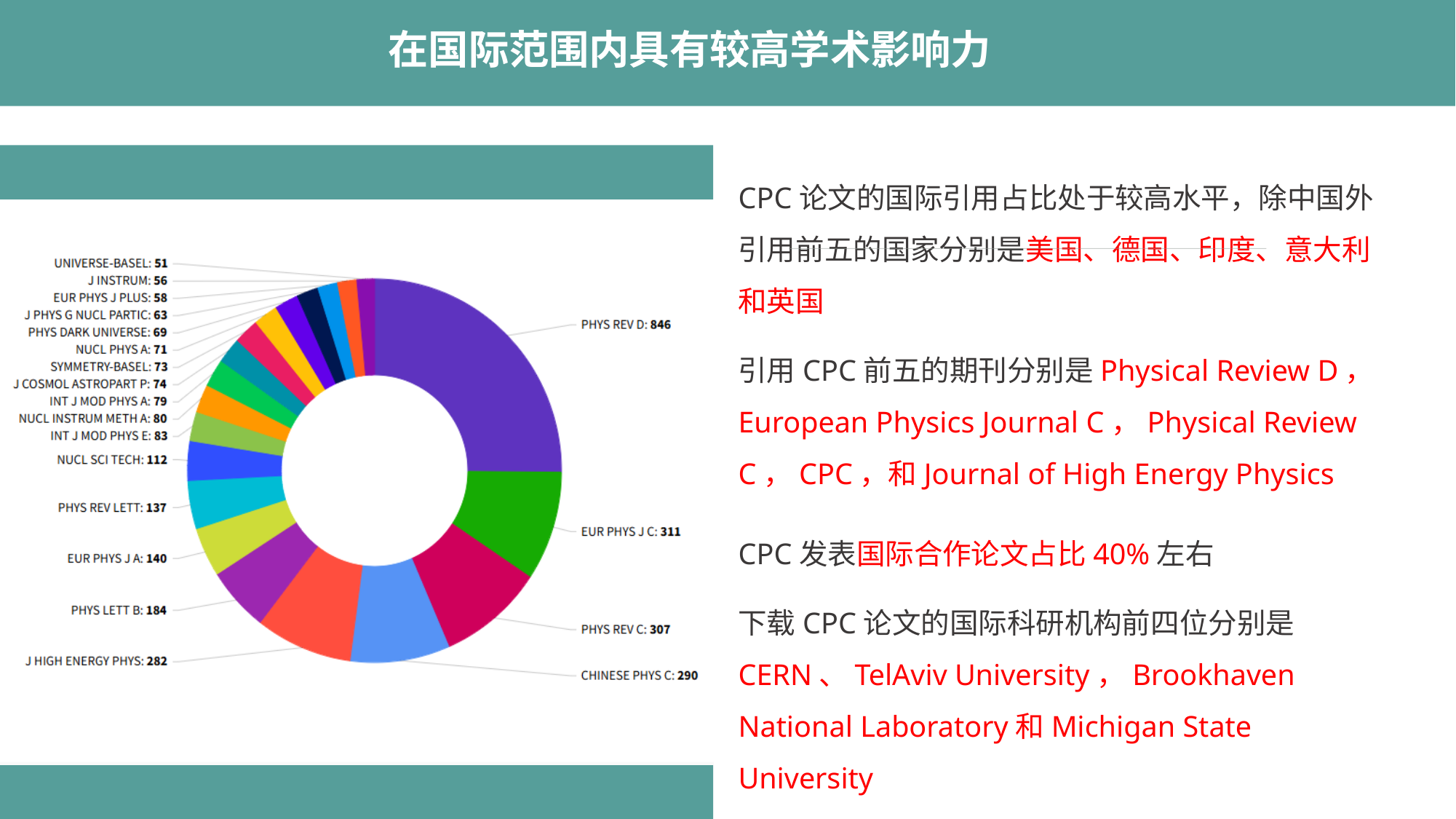
Which category has the largest slice in the pie chart? PHYS REV D What is the value for PHYS REV D in the pie chart? 846 What is the difference between the values for PHYS REV D and EUR PHYS J C? 535 What type of chart is shown on the slide? Pie (donut) chart What is the value for J INSTRUM in the pie chart? 56 What is the difference between the values for PHYS LETT B and EUR PHYS J A? 44 Which is larger, the value for J HIGH ENERGY PHYS or the value for PHYS LETT B? J HIGH ENERGY PHYS What is the value for NUCL SCI TECH in the pie chart? 112 What is the combined value of EUR PHYS J C and PHYS REV C? 618 What is the value for CHINESE PHYS C in the pie chart? 290